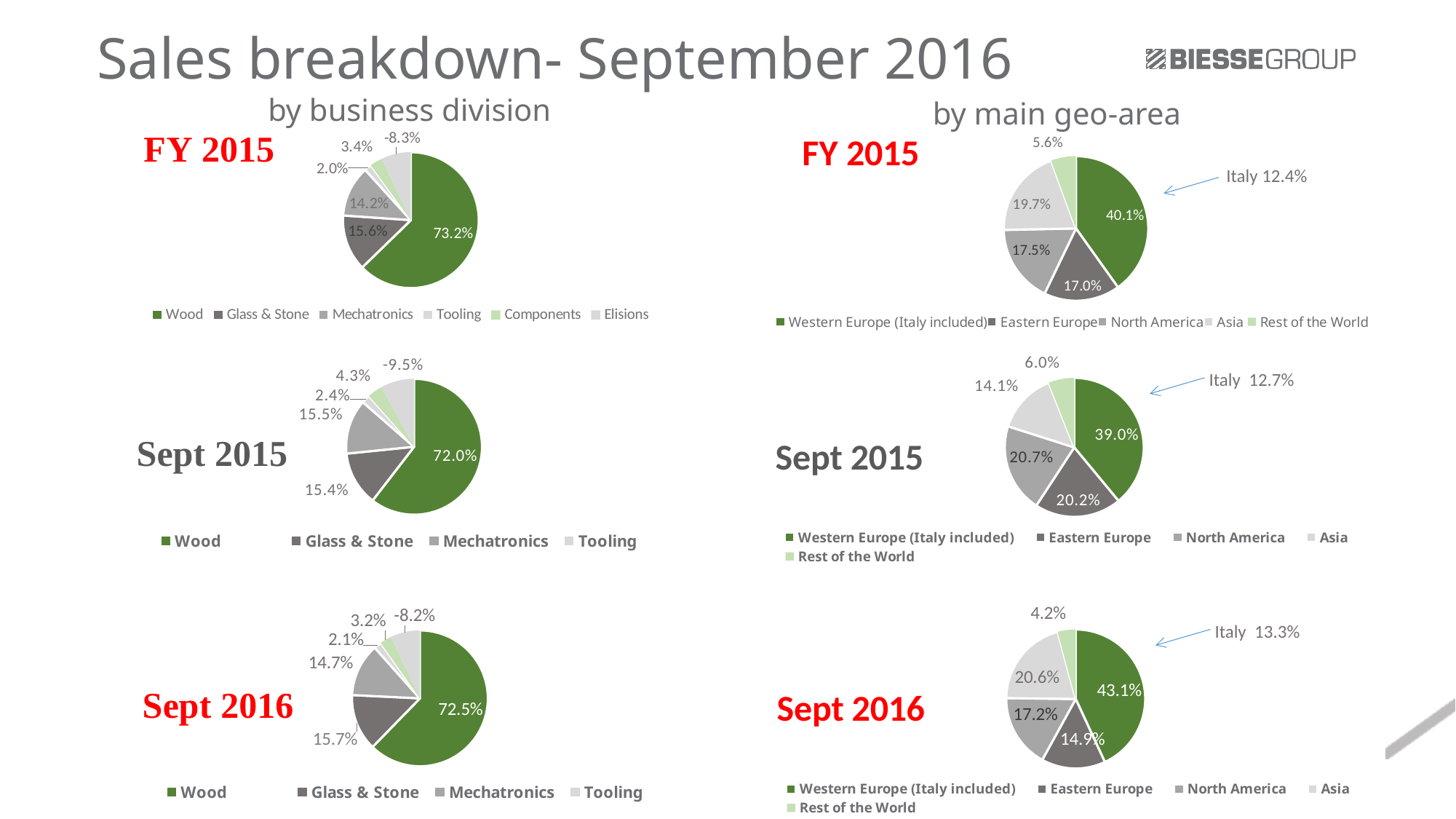
In the 'by main geo-area' FY 2015 pie chart, what is the value for Asia? 19.7% What Italy share is annotated next to the 'by main geo-area' Sept 2016 pie chart? 13.3% In the 'by business division' Sept 2015 pie chart, which category has the largest share? Wood How many entries does the legend of the 'by business division' FY 2015 pie chart list? 6 In the 'by business division' Sept 2016 pie chart, what is the value for Glass & Stone? 15.7% What type of chart is used for the Sept 2016 'by main geo-area' breakdown? Pie chart In the 'by main geo-area' Sept 2016 pie chart, what is the difference between the Asia share and the Eastern Europe share? 5.7% In the 'by business division' FY 2015 pie chart, what share does Wood have? 73.2% In the 'by main geo-area' Sept 2016 pie chart, which category has the smallest share? Rest of the World In the 'by main geo-area' Sept 2015 pie chart, what is the value for Rest of the World? 6.0% In the 'by main geo-area' Sept 2016 pie chart, what share does Western Europe (Italy included) have? 43.1% In the 'by main geo-area' FY 2015 pie chart, which is larger: North America or Eastern Europe? North America